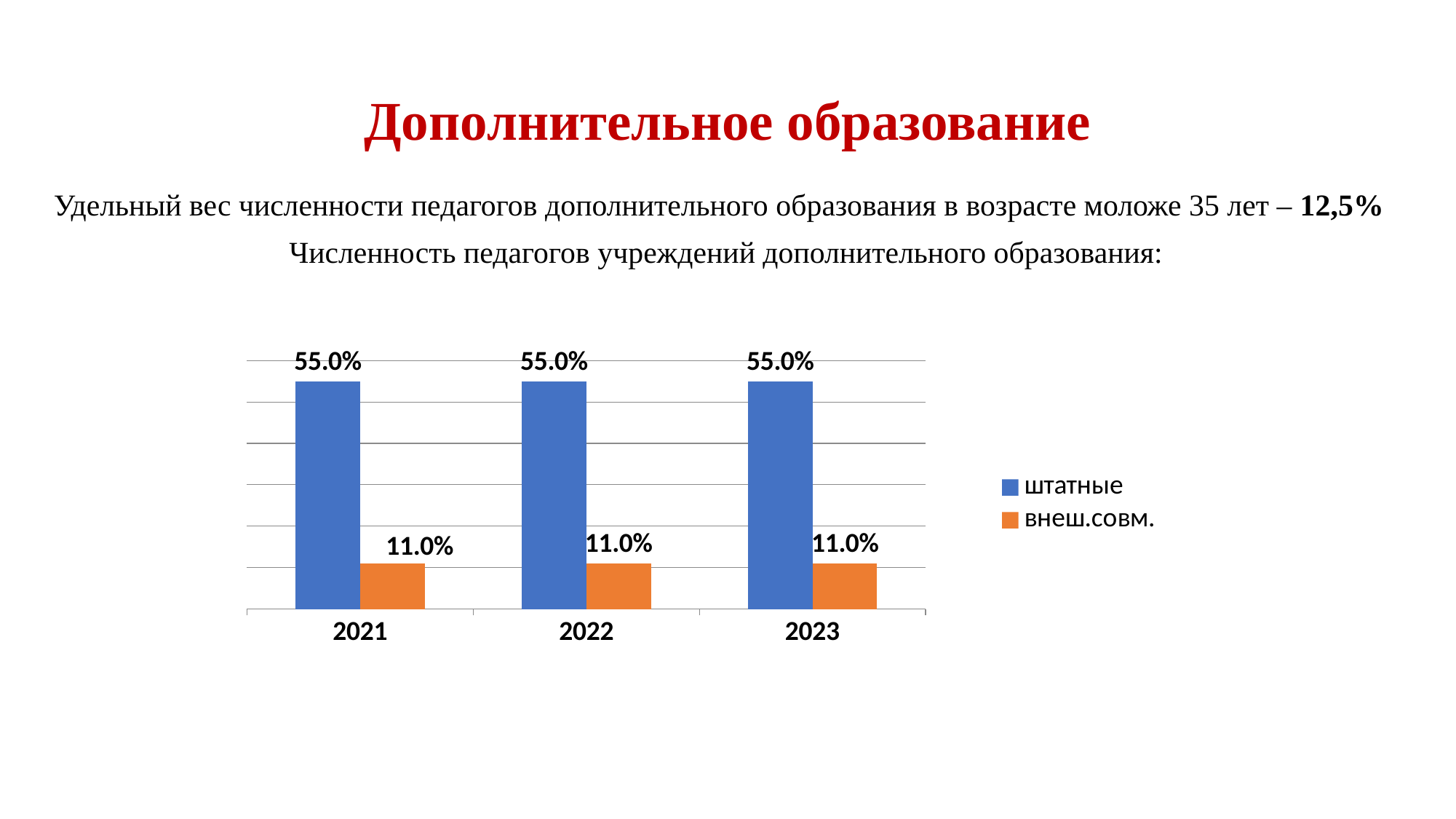
What is the difference between the штатные and внеш.совм. values in 2021? 44.0% Which series has the higher value in 2023, штатные or внеш.совм.? штатные What kind of chart is shown on the slide? bar chart How many series does the legend list? 2 What is the first year shown on the x axis of the chart? 2021 What is the value for штатные in 2021? 55.0% Do the штатные values rise, fall or stay the same from 2021 to 2023? stay the same What is the value for внеш.совм. in 2022? 11.0% What is the value for штатные in 2022? 55.0% What is the value for внеш.совм. in 2023? 11.0% Which series is shown in orange in the chart? внеш.совм. How many years are shown on the x axis of the chart? 3